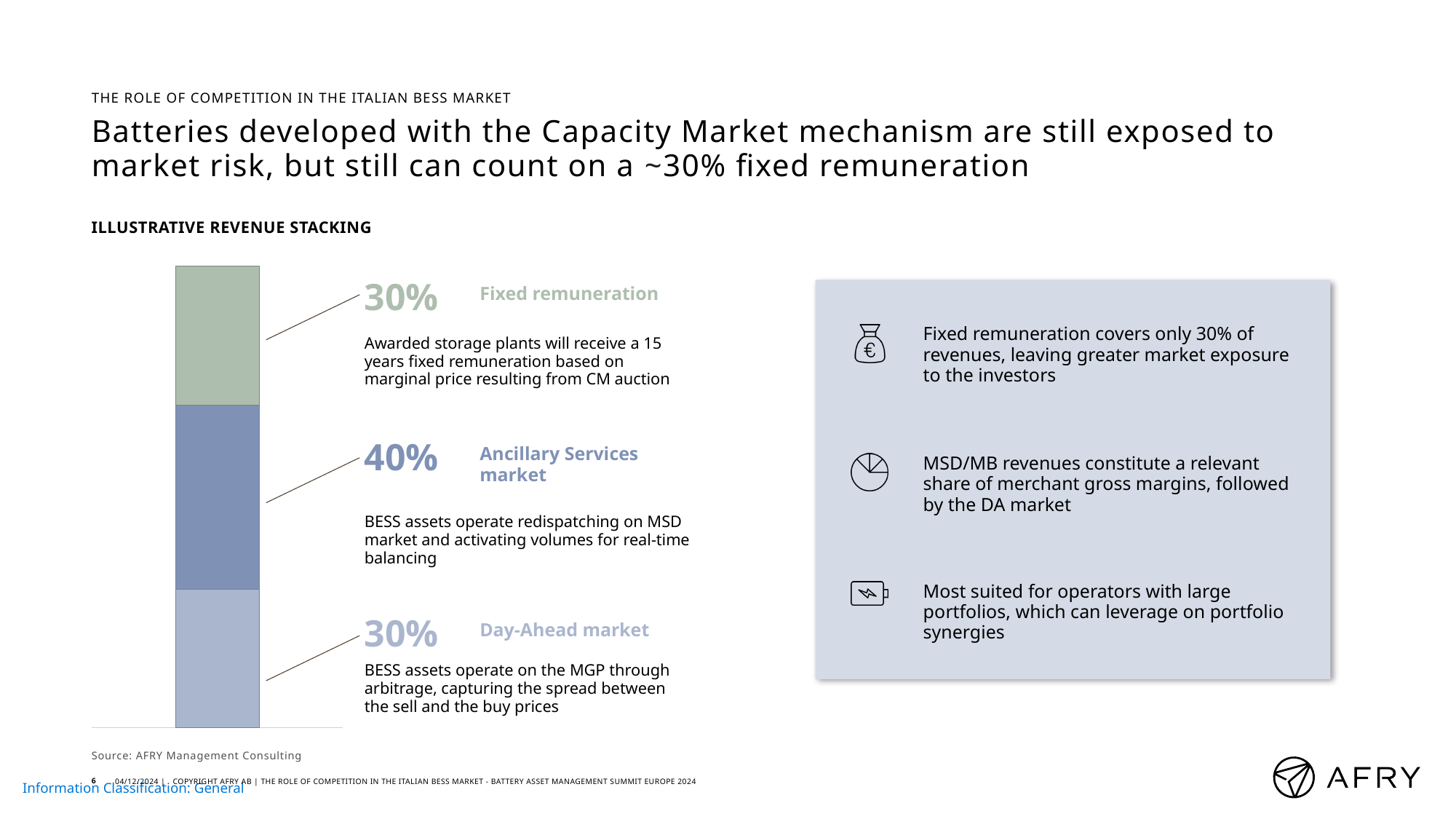
How many segments make up the stacked bar in the illustrative revenue stacking chart? 3 What is the difference between the Ancillary Services market share and the Day-Ahead market share in the illustrative revenue stacking chart? 10% Which is larger in the illustrative revenue stacking chart: the Ancillary Services market share or the Fixed remuneration share? Ancillary Services market What type of chart is used for the illustrative revenue stacking? Stacked bar chart What share of revenue does the Day-Ahead market segment represent in the illustrative revenue stacking chart? 30% What share of revenue does the Fixed remuneration segment represent in the illustrative revenue stacking chart? 30% What is the total of all segments in the illustrative revenue stacking bar? 100% Which segment sits at the top of the illustrative revenue stacking bar? Fixed remuneration Do the Fixed remuneration and Day-Ahead market segments have the same share in the illustrative revenue stacking chart? Yes Which segment of the illustrative revenue stacking bar is the largest? Ancillary Services market What is the title of the chart on the slide? ILLUSTRATIVE REVENUE STACKING What share of revenue does the Ancillary Services market segment represent in the illustrative revenue stacking chart? 40%